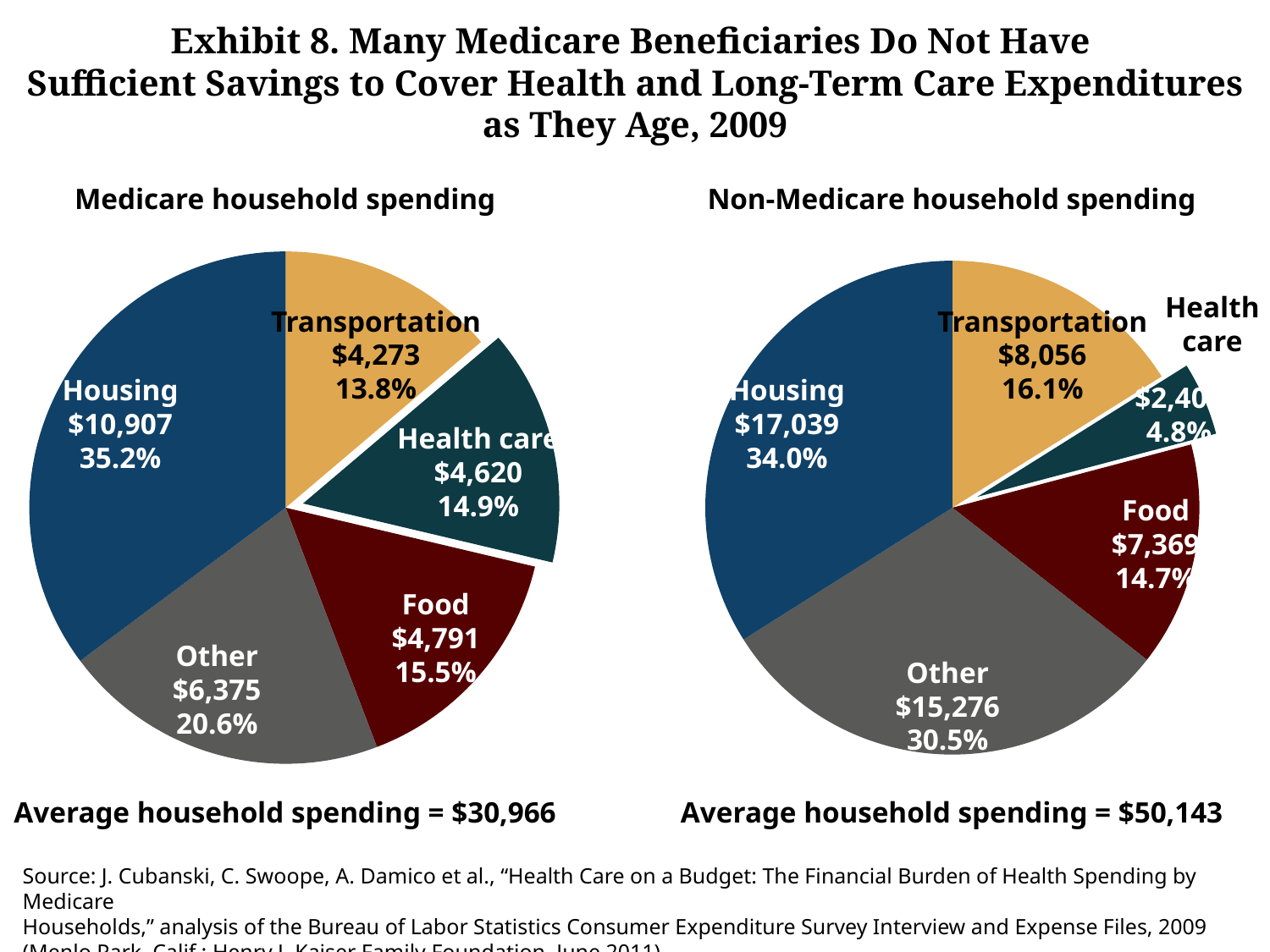
What type of chart is used for Medicare household spending? Pie chart In the Medicare household spending chart, what is the dollar value for Housing? $10,907 In the Non-Medicare household spending chart, what is the dollar value for Transportation? $8,056 In the Medicare household spending chart, what share of spending goes to Health care? 14.9% How many categories are shown in the Non-Medicare household spending chart? 5 In the Non-Medicare household spending chart, which category has the smallest share? Health care In the Medicare household spending chart, which is larger: Food or Transportation? Food In the Medicare household spending chart, what is the difference in dollars between Other and Food? $1,584 In the Non-Medicare household spending chart, what share of spending goes to Health care? 4.8% What is the average household spending shown below the Non-Medicare household spending chart? $50,143 In the Medicare household spending chart, which category has the largest share? Housing In the Non-Medicare household spending chart, what is the dollar value for Other? $15,276